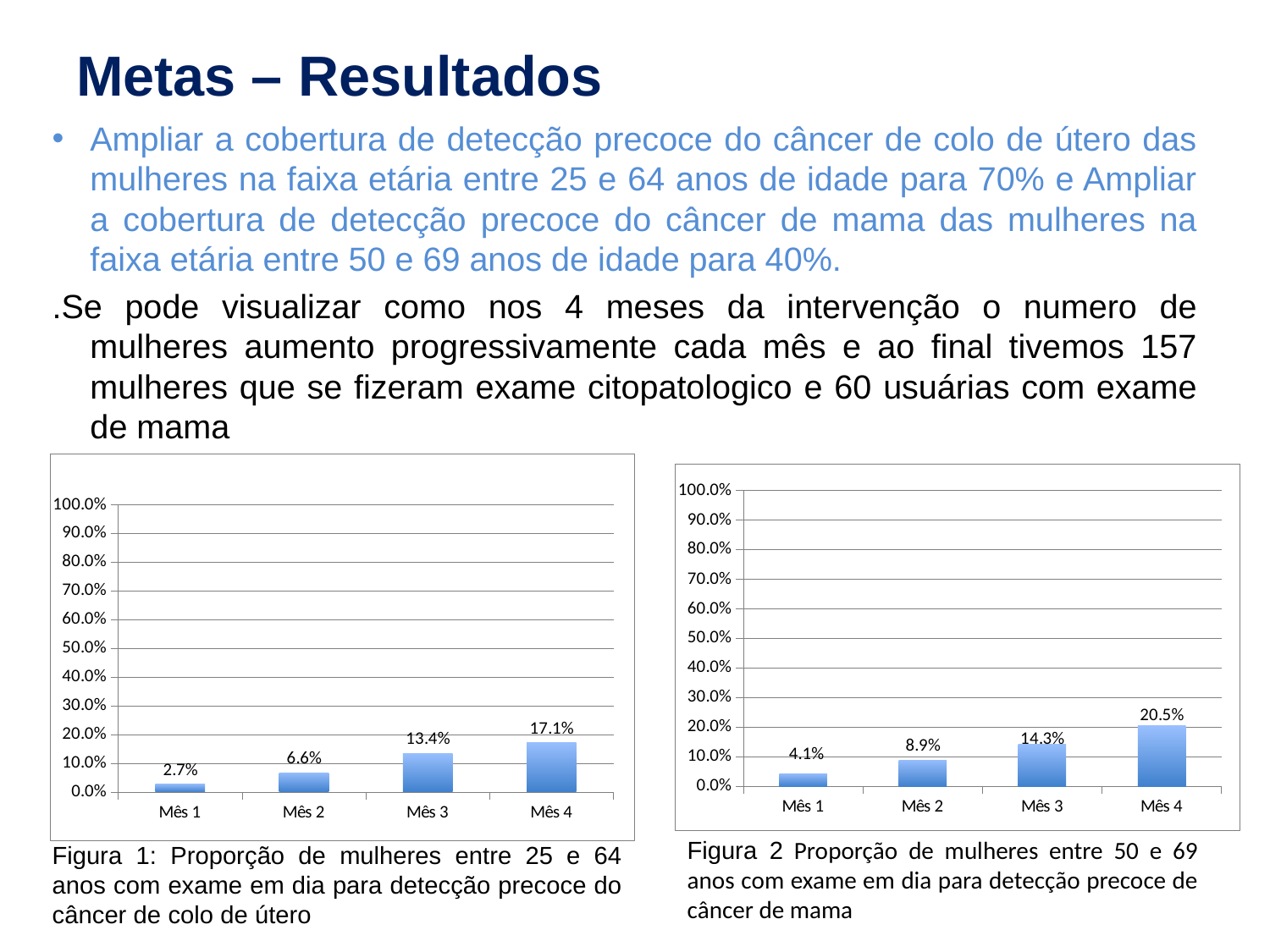
In the right chart (Figura 2), do the values rise or fall from Mês 1 to Mês 4? rise How many months are shown on the x axis of the left chart (Figura 1)? 4 What kind of chart is the right chart (Figura 2)? bar chart In the right chart (Figura 2), which month has the lowest value? Mês 1 In the left chart (Figura 1), what is the value for Mês 3? 13.4% In the right chart (Figura 2), what is the value for Mês 2? 8.9% In the right chart (Figura 2), what is the difference between the values for Mês 4 and Mês 3? 6.2% What is the maximum value shown on the y axis of the left chart (Figura 1)? 100.0% In the right chart (Figura 2), which is larger, the value for Mês 2 or the value for Mês 3? Mês 3 In the left chart (Figura 1), is the value for Mês 4 greater or less than 20.0%? less In the left chart (Figura 1), what is the difference between the values for Mês 4 and Mês 1? 14.4% In the left chart (Figura 1), which month has the highest value? Mês 4